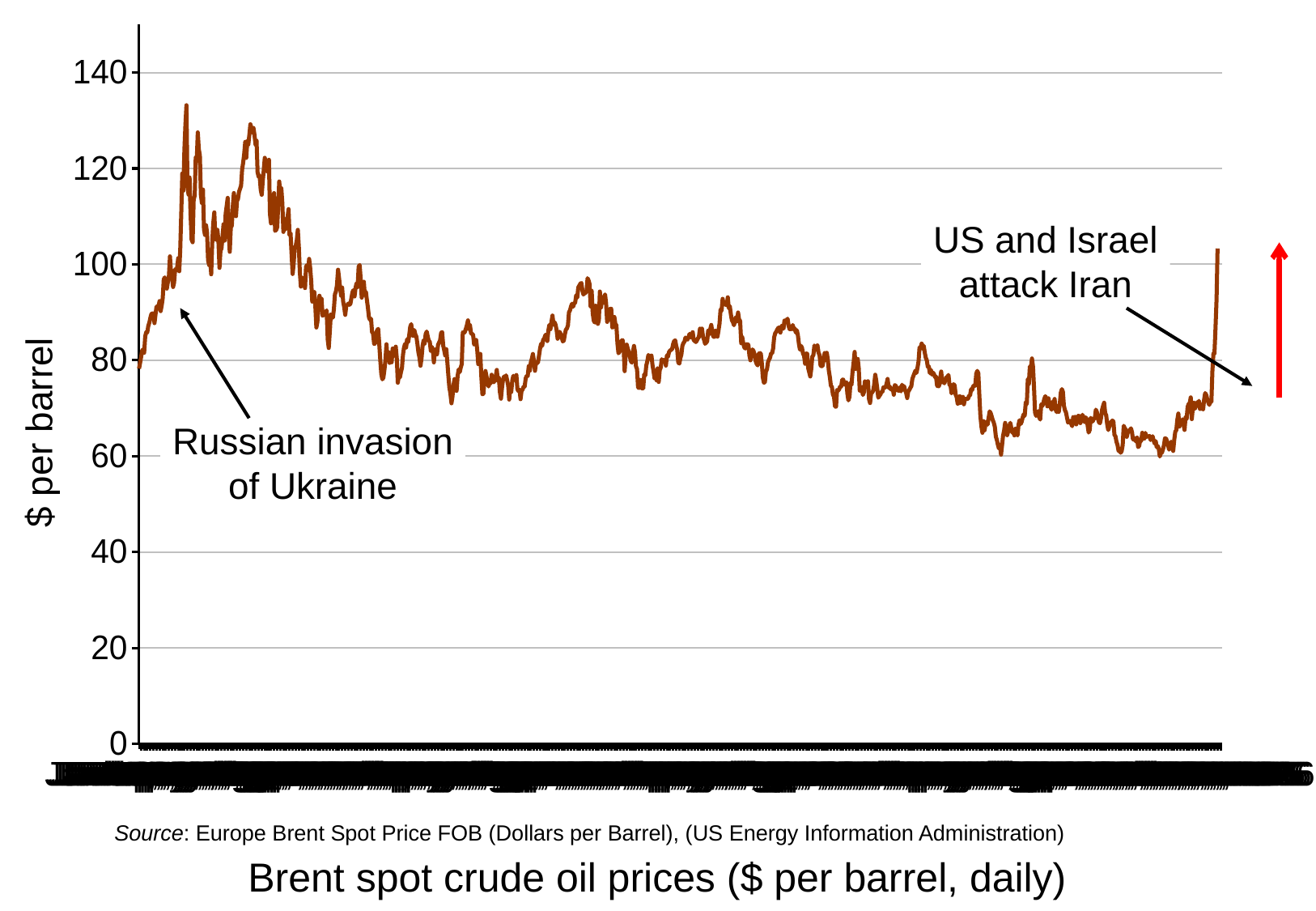
How many data series are plotted on the chart? 1 What is the label on the vertical axis of the chart? $ per barrel Is the value at the point marked 'Russian invasion of Ukraine' greater or less than 100? less Is the lowest value reached by the line greater or less than 80? less Is the highest value reached by the line greater or less than 120? greater Does the price generally rise or fall between the 'Russian invasion of Ukraine' annotation and the 'US and Israel attack Iran' annotation? fall What event does the annotation near the left of the chart refer to? Russian invasion of Ukraine What kind of chart is shown on the slide? Line chart